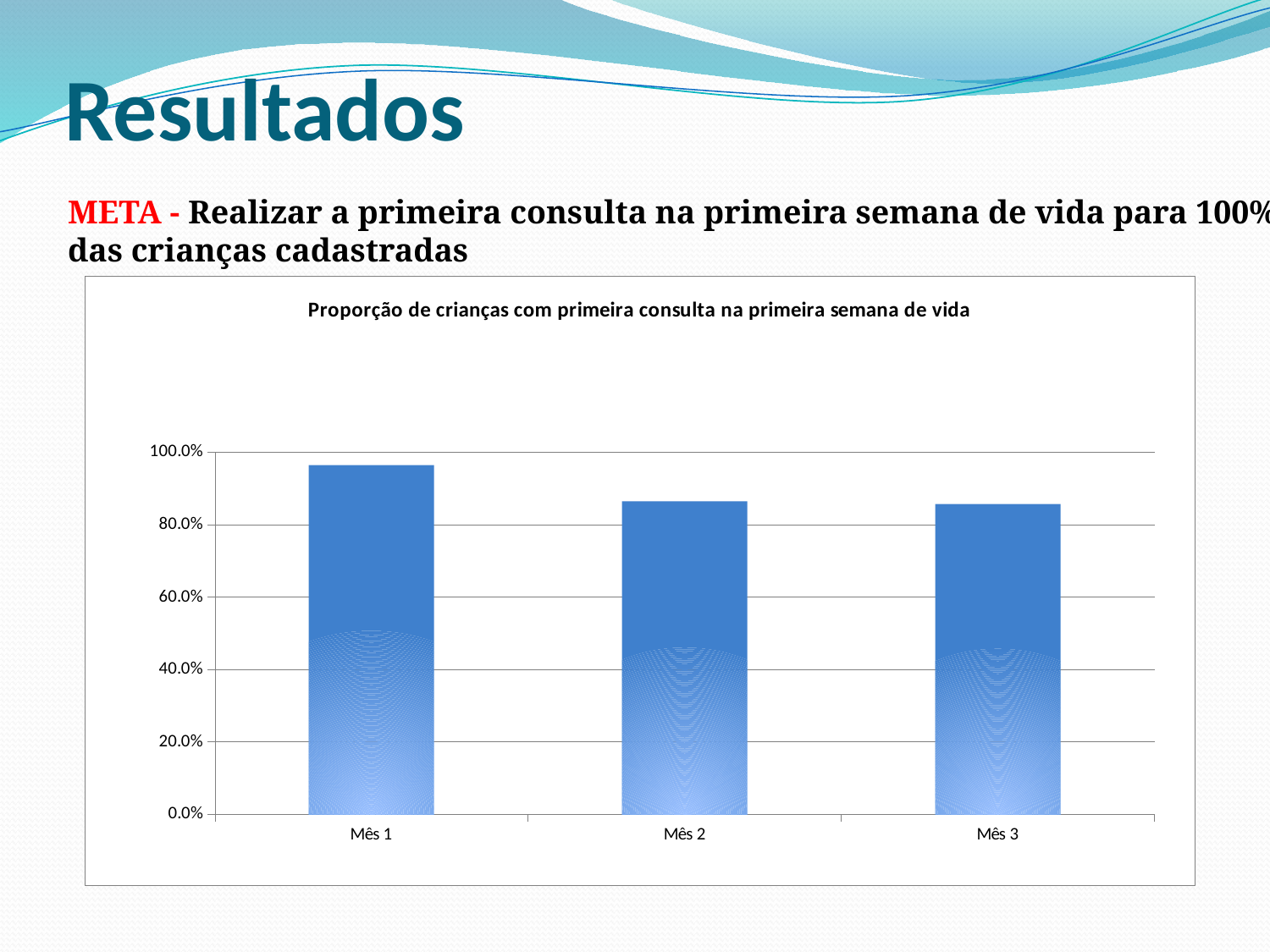
What is the title of the chart? Proporção de crianças com primeira consulta na primeira semana de vida How many categories (months) are plotted on the x axis? 3 Which month has the highest bar? Mês 1 Do the values rise or fall from Mês 1 to Mês 3? fall Which is larger, the value for Mês 1 or the value for Mês 3? Mês 1 Is the value for Mês 1 greater or less than 100.0%? less Is the value for Mês 2 greater or less than 80.0%? greater What is the label of the first category on the x axis? Mês 1 Is the value for Mês 1 greater or less than 80.0%? greater What kind of chart is shown on the slide? bar chart